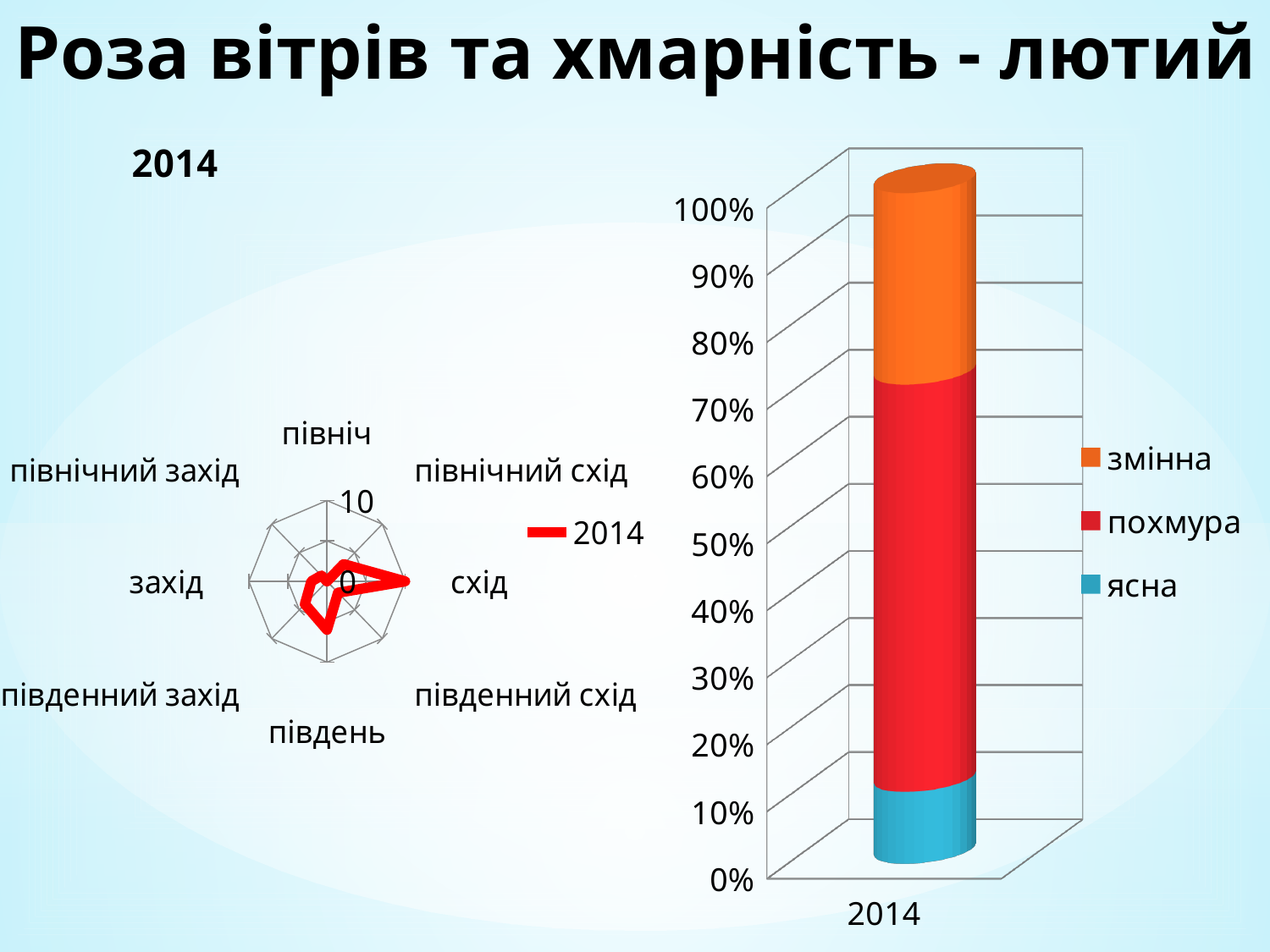
In the radar chart on the left, which direction has the highest value? схід In the stacked bar chart on the right, how many categories are shown on the x axis? 1 In the radar chart on the left, how many direction categories are plotted? 8 In the stacked bar chart on the right, which series takes up the smallest share of the 2014 bar? ясна In the stacked bar chart on the right, how many series does the legend list? 3 What kind of chart is the chart on the right of the slide? bar chart In the stacked bar chart on the right, is the value for ясна in 2014 greater or less than 20%? less What kind of chart is the chart on the left of the slide? radar chart In the stacked bar chart on the right, which series takes up the largest share of the 2014 bar? похмура In the radar chart on the left, how many series does the legend list? 1 In the radar chart on the left, what is the maximum value shown on the radial axis? 10 In the radar chart on the left, what is the name of the series shown in the legend? 2014